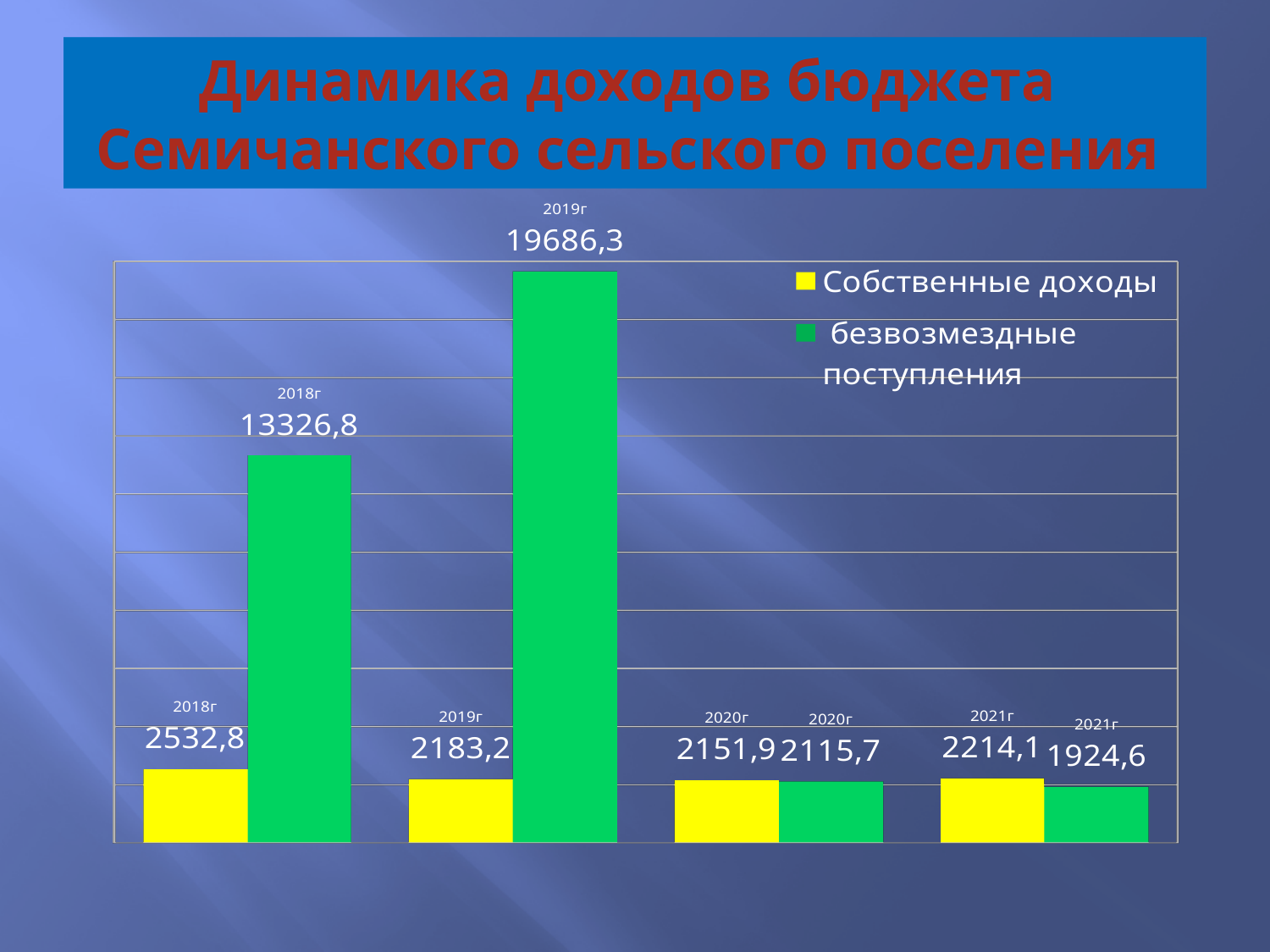
What is the value of безвозмездные поступления for 2019г? 19686,3 What is the value of безвозмездные поступления for 2021г? 1924,6 How many series does the legend list? 2 What is the value of Собственные доходы for 2018г? 2532,8 In which year is безвозмездные поступления highest? 2019г What kind of chart is shown on the slide? Bar chart In which year is безвозмездные поступления lowest? 2021г In which year is Собственные доходы highest? 2018г Which colour represents Собственные доходы in the chart? Yellow Which is larger in 2021г, Собственные доходы or безвозмездные поступления? Собственные доходы What is the value of Собственные доходы for 2020г? 2151,9 What is the difference between безвозмездные поступления in 2019г and 2018г? 6359,5